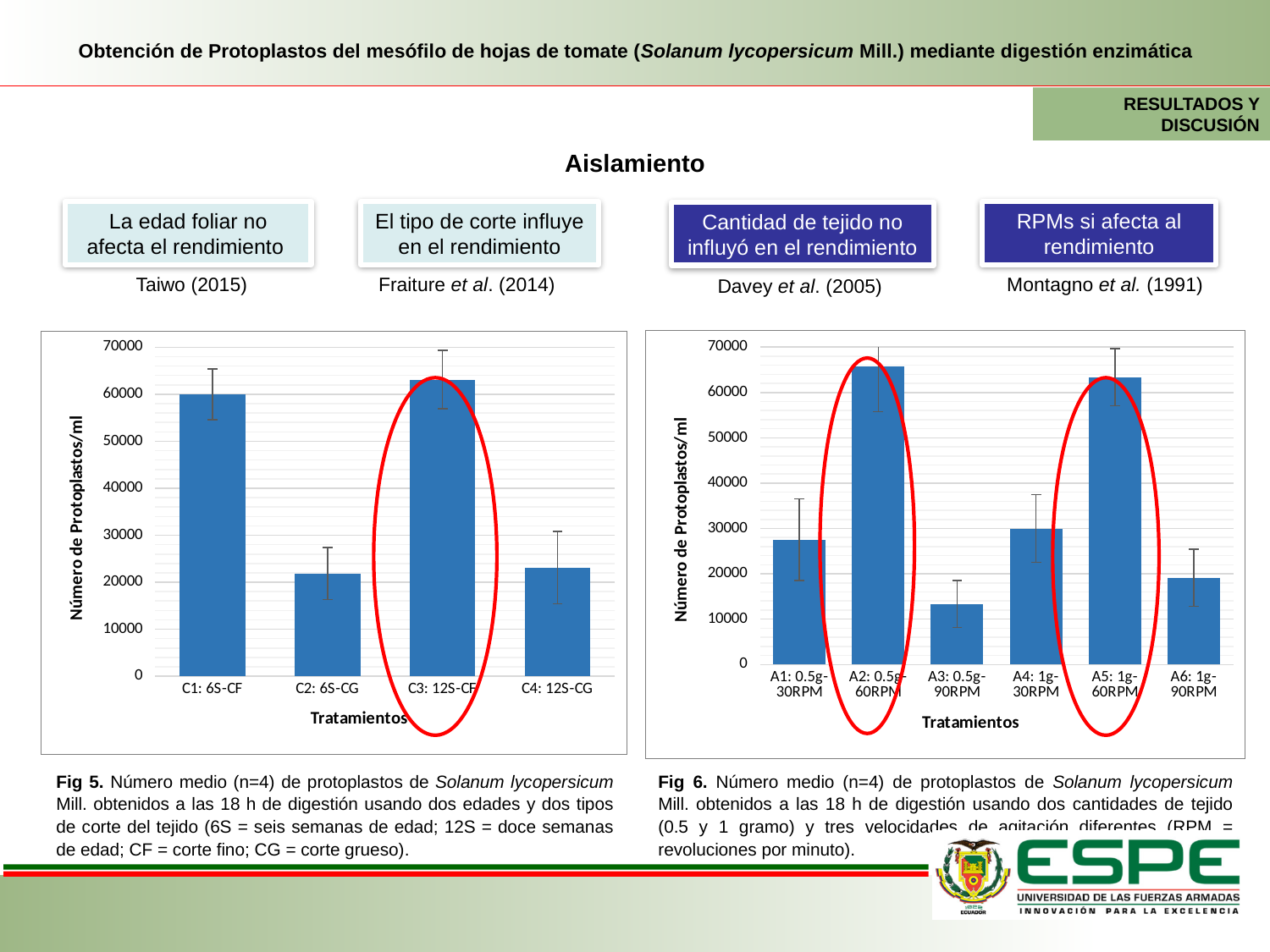
In the right chart (Fig 6), is the value for A5: 1g-60RPM greater or less than 60000? greater In the left chart (Fig 5), is the value for C2: 6S-CG greater or less than 30000? less In the right chart (Fig 6), how many treatment categories are shown on the x axis? 6 In the right chart (Fig 6), is the value for A4: 1g-30RPM greater or less than 40000? less In the right chart (Fig 6), which treatment has the lowest number of protoplasts/ml? A3: 0.5g-90RPM In the left chart (Fig 5), how many treatment categories are shown on the x axis? 4 In the left chart (Fig 5), which is larger, the value for C3: 12S-CF or the value for C4: 12S-CG? C3: 12S-CF In the right chart (Fig 6), which is larger, the value for A2: 0.5g-60RPM or the value for A6: 1g-90RPM? A2: 0.5g-60RPM What kind of chart is the left chart (Fig 5)? Bar chart What is the y-axis title of the left chart (Fig 5)? Número de Protoplastos/ml